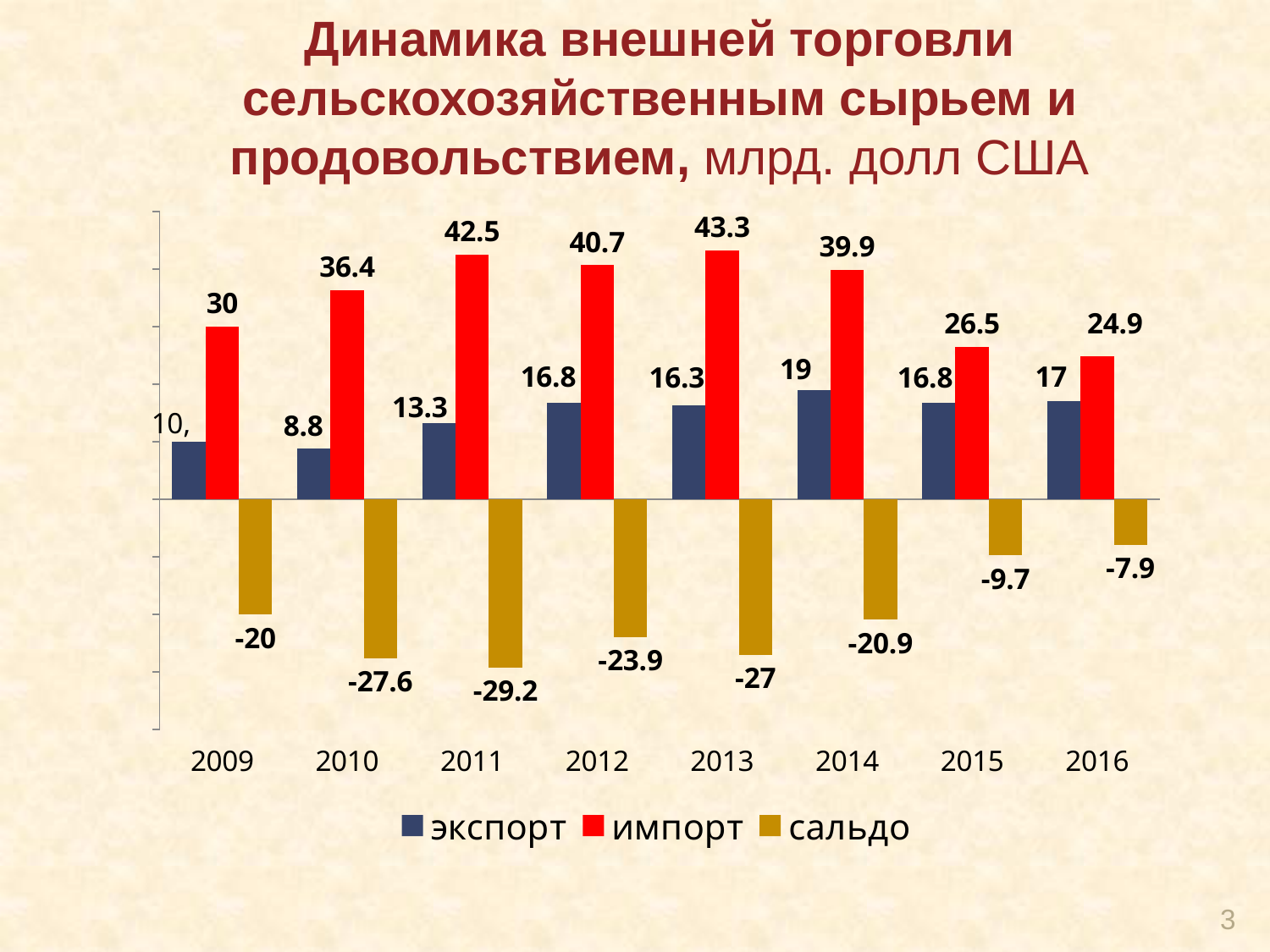
In which year is экспорт the lowest? 2010 What is the value of сальдо for 2011? -29.2 In which year is импорт the highest? 2013 Does импорт rise or fall from 2013 to 2016? fall Which is larger, импорт in 2011 or импорт in 2014? импорт in 2011 What is the value of экспорт for 2014? 19 How many years are shown on the x axis? 8 What is the value of импорт for 2016? 24.9 What kind of chart is shown on the slide? bar chart What is the difference between импорт and экспорт in 2012? 23.9 How many series does the legend list? 3 What is the value of импорт for 2013? 43.3